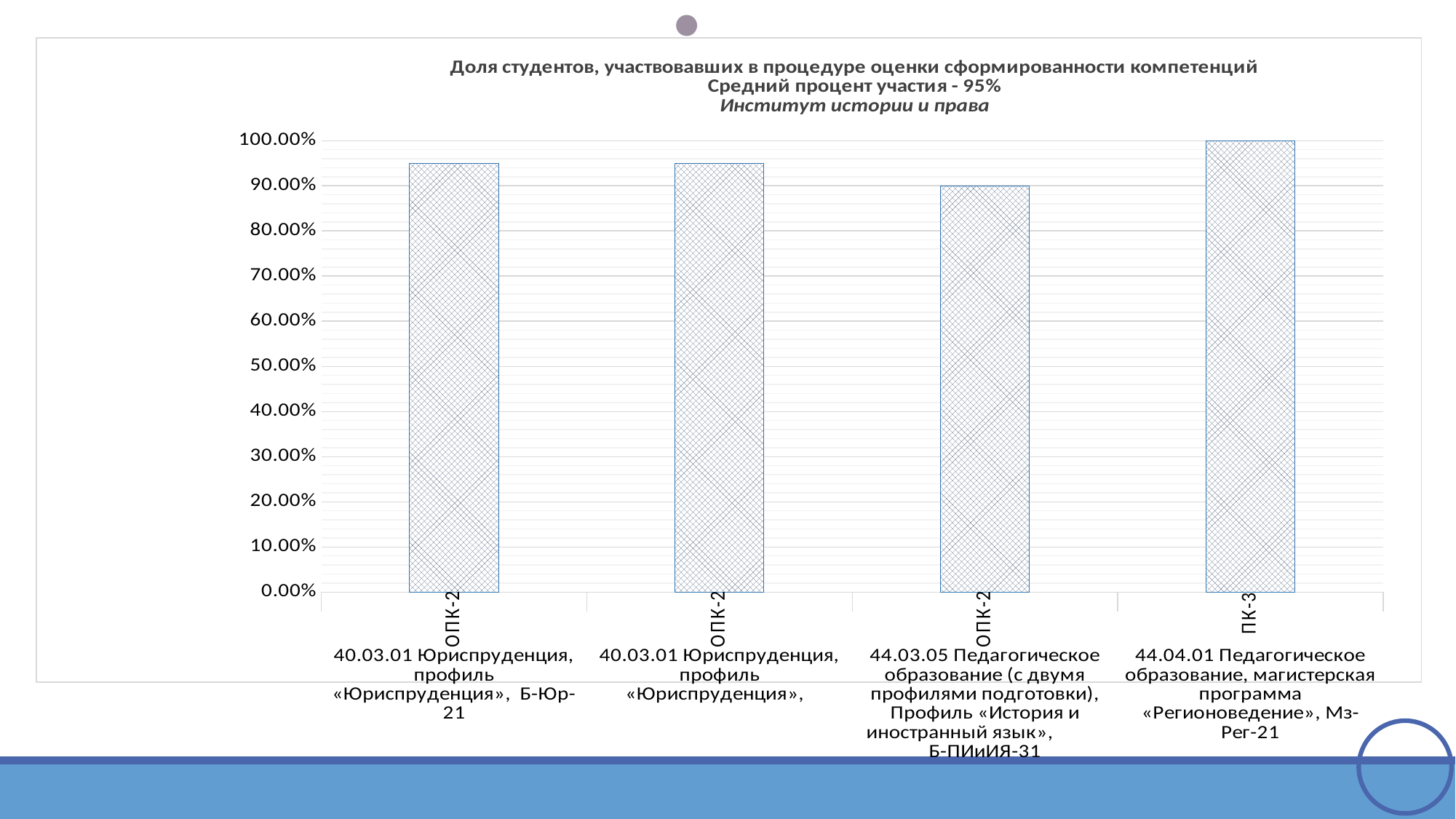
Is the value for ОПК-2 (40.03.01 Юриспруденция, Б-Юр-21) greater or less than 90.00%? greater What is the value for ОПК-2 (44.03.05 Педагогическое образование, Б-ПИиИЯ-31)? 90.00% How many bars are plotted in the chart? 4 Which category has the lowest bar? ОПК-2 (44.03.05 Педагогическое образование, Б-ПИиИЯ-31) Is the value for ОПК-2 (40.03.01 Юриспруденция, Б-Юр-21) greater or less than 100.00%? less What kind of chart is shown on the slide? bar chart Which is larger: the value for ОПК-2 (40.03.01 Юриспруденция, Б-Юр-21) or the value for ОПК-2 (44.03.05 Педагогическое образование, Б-ПИиИЯ-31)? ОПК-2 (40.03.01 Юриспруденция, Б-Юр-21) Which institute is named in the chart title? Институт истории и права What is the value for ПК-3 (44.04.01 Педагогическое образование, Мз-Рег-21)? 100.00% Which category has the highest bar? ПК-3 (44.04.01 Педагогическое образование, магистерская программа «Регионоведение», Мз-Рег-21) According to the chart title, what is the average participation percentage (Средний процент участия)? 95% What is the difference between the value for ПК-3 (Мз-Рег-21) and the value for ОПК-2 (Б-ПИиИЯ-31)? 10.00%